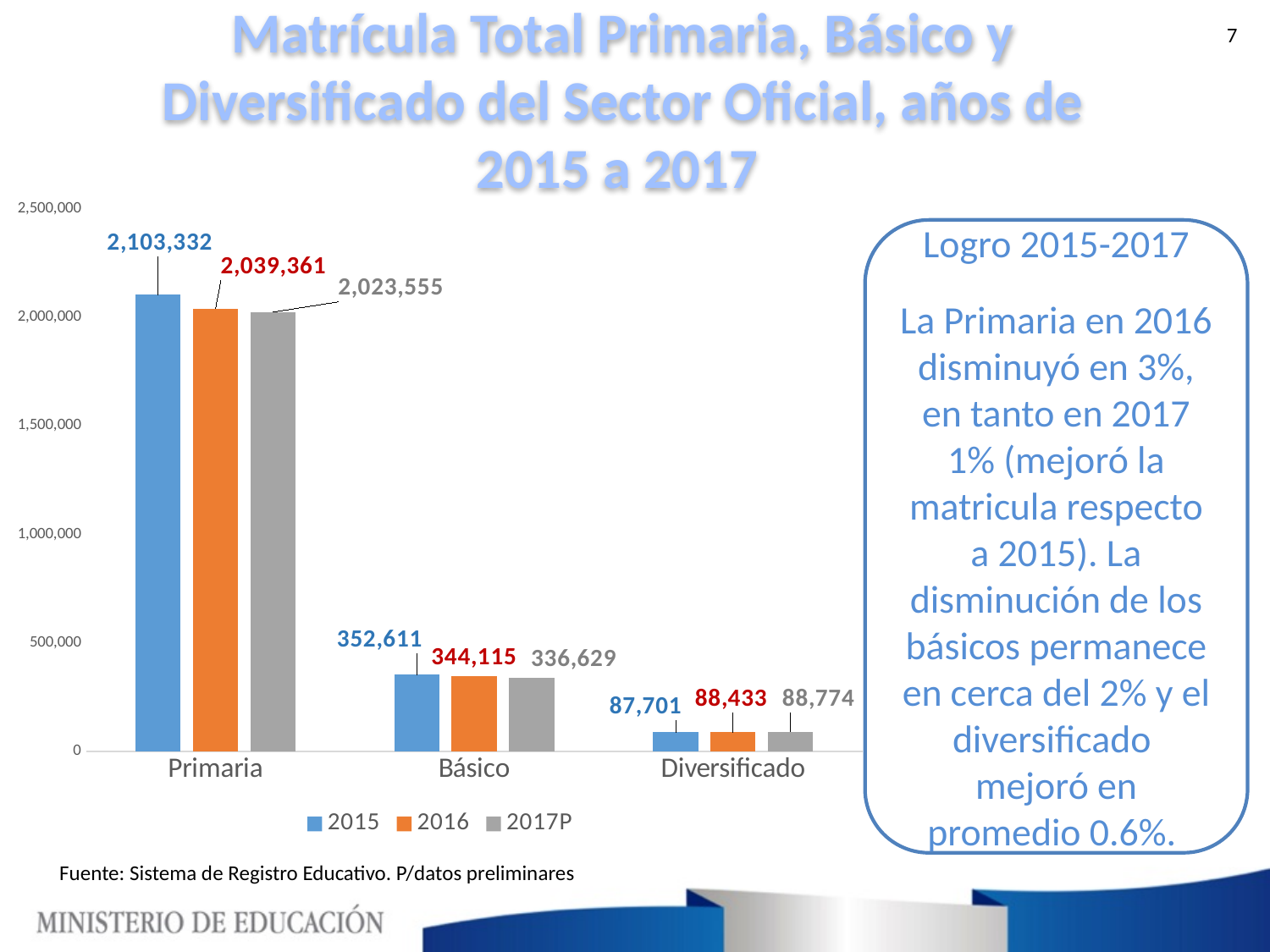
How many series does the legend list? 3 Which category has the highest enrollment in 2017P? Primaria Which is larger: Diversificado in 2016 or Diversificado in 2015? Diversificado in 2016 Do the Básico values rise or fall from 2015 to 2017P? fall What is the enrollment value for Básico in 2016? 344,115 What is the enrollment value for Primaria in 2015? 2,103,332 What is the enrollment value for Diversificado in 2017P? 88,774 Is the value for Básico in 2015 greater or less than 500,000? less Which category has the lowest enrollment in 2015? Diversificado What kind of chart is shown on the slide? bar chart What is the difference between the Primaria values for 2015 and 2016? 63,971 How many categories are shown on the x axis? 3